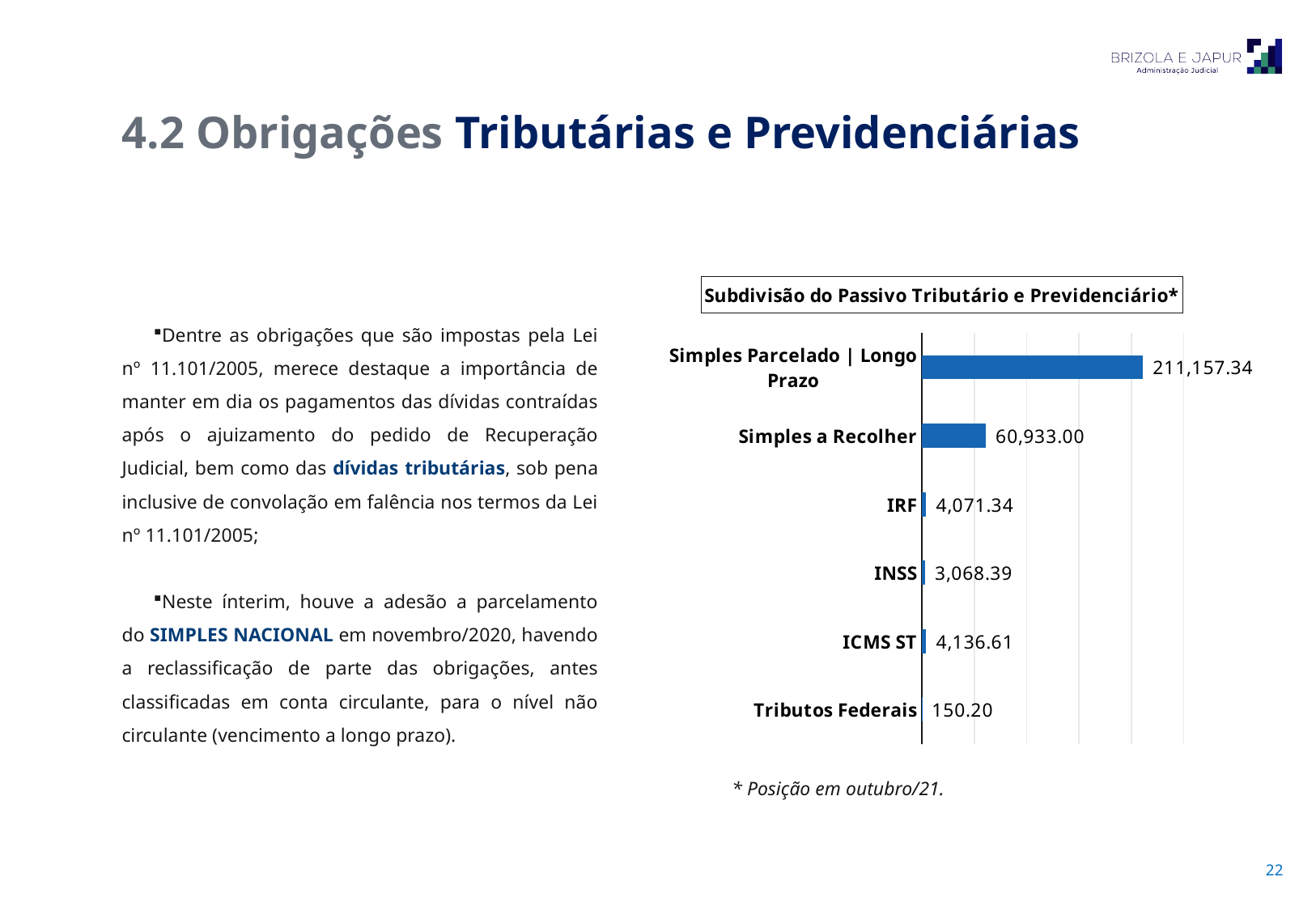
What is the title of the chart? Subdivisão do Passivo Tributário e Previdenciário* What is the value for Simples Parcelado | Longo Prazo in the chart? 211,157.34 What is the value for Simples a Recolher? 60,933.00 What is the value shown for Tributos Federais? 150.20 What is the difference between the values for IRF and INSS? 1,002.95 Which is larger, the value for Simples a Recolher or the value for ICMS ST? Simples a Recolher What kind of chart is shown on the slide? Bar chart Which category has the highest value in the chart? Simples Parcelado | Longo Prazo What is the value shown for INSS? 3,068.39 Which category has the lowest value in the chart? Tributos Federais How many categories are shown in the chart? 6 What is the difference between the values for Simples Parcelado | Longo Prazo and Simples a Recolher? 150,224.34